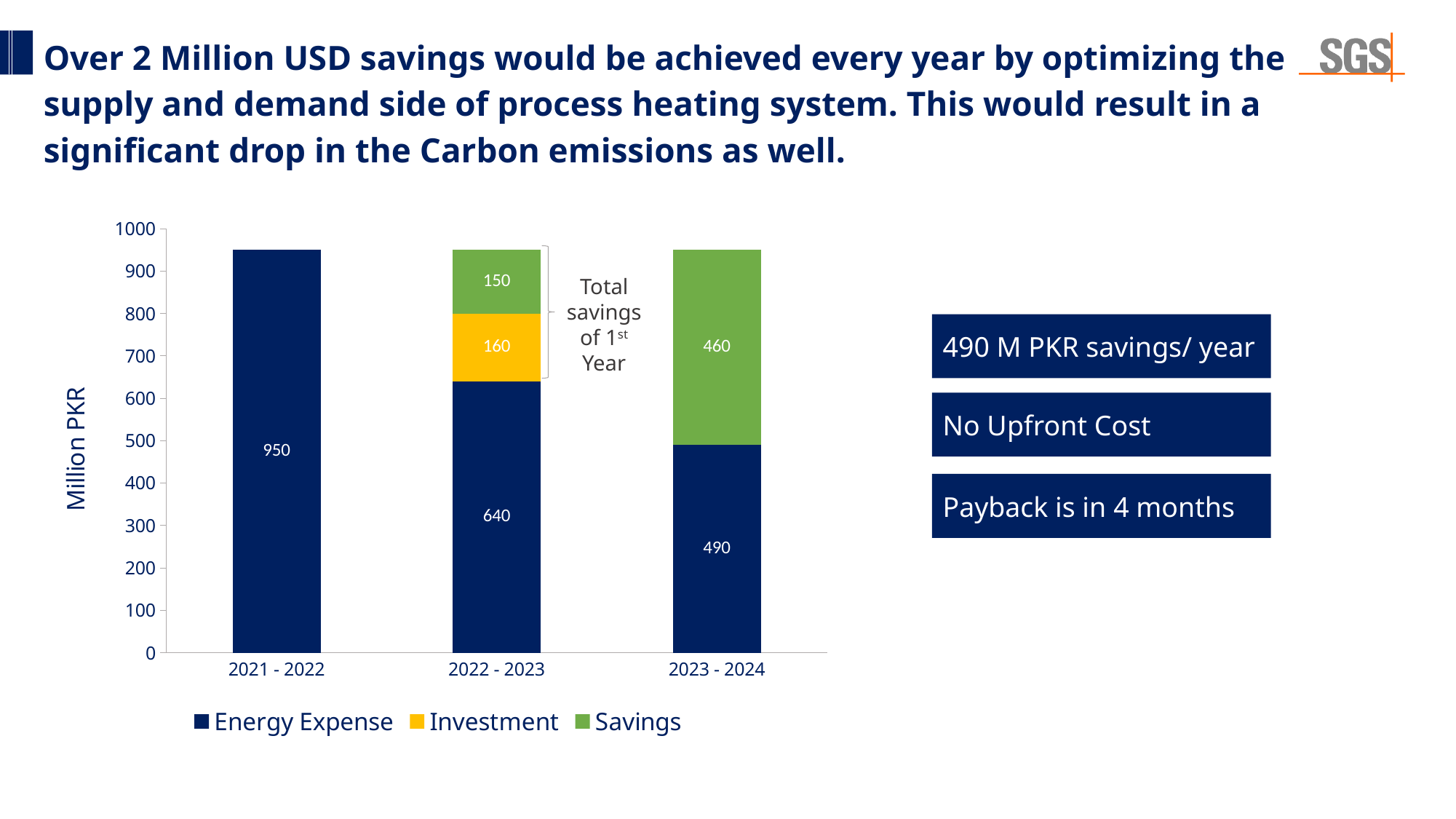
What is the label on the vertical axis of the chart? Million PKR What is the Energy Expense value for 2021 - 2022? 950 What is the Savings value for 2023 - 2024? 460 Which year has the lowest Energy Expense? 2023 - 2024 What is the Energy Expense value for 2022 - 2023? 640 Which year has the highest Energy Expense? 2021 - 2022 How many series does the legend list? 3 What is the Investment value for 2022 - 2023? 160 What kind of chart is shown on the slide? Stacked bar chart Is the Savings value larger in 2022 - 2023 or in 2023 - 2024? 2023 - 2024 What is the total of the stacked bar for 2022 - 2023? 950 What is the difference between the Energy Expense in 2021 - 2022 and in 2023 - 2024? 460